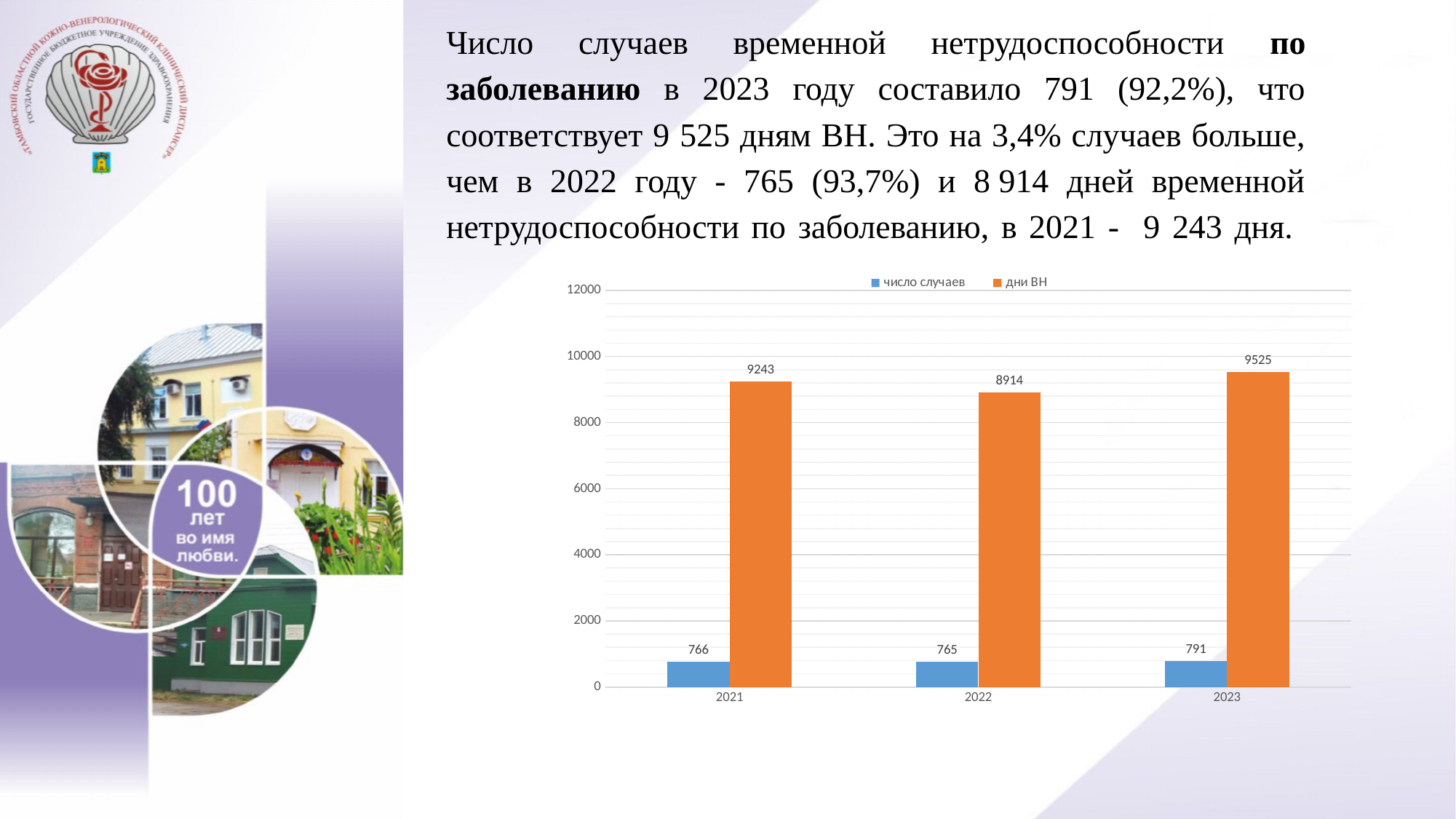
Is the value for 'дни ВН' in 2022 greater or less than 10000? less What is the value of 'число случаев' for 2021? 766 How many series does the legend list? 2 Which is larger: 'дни ВН' in 2021 or in 2022? 2021 What kind of chart is shown on the slide? bar chart What is the value of 'дни ВН' for 2023? 9525 What is the difference between 'дни ВН' in 2023 and 2022? 611 What is the value of 'число случаев' for 2023? 791 Which year has the lowest value for 'дни ВН'? 2022 How many years are shown on the x axis? 3 Which year has the highest value for 'дни ВН'? 2023 What is the value of 'дни ВН' for 2022? 8914